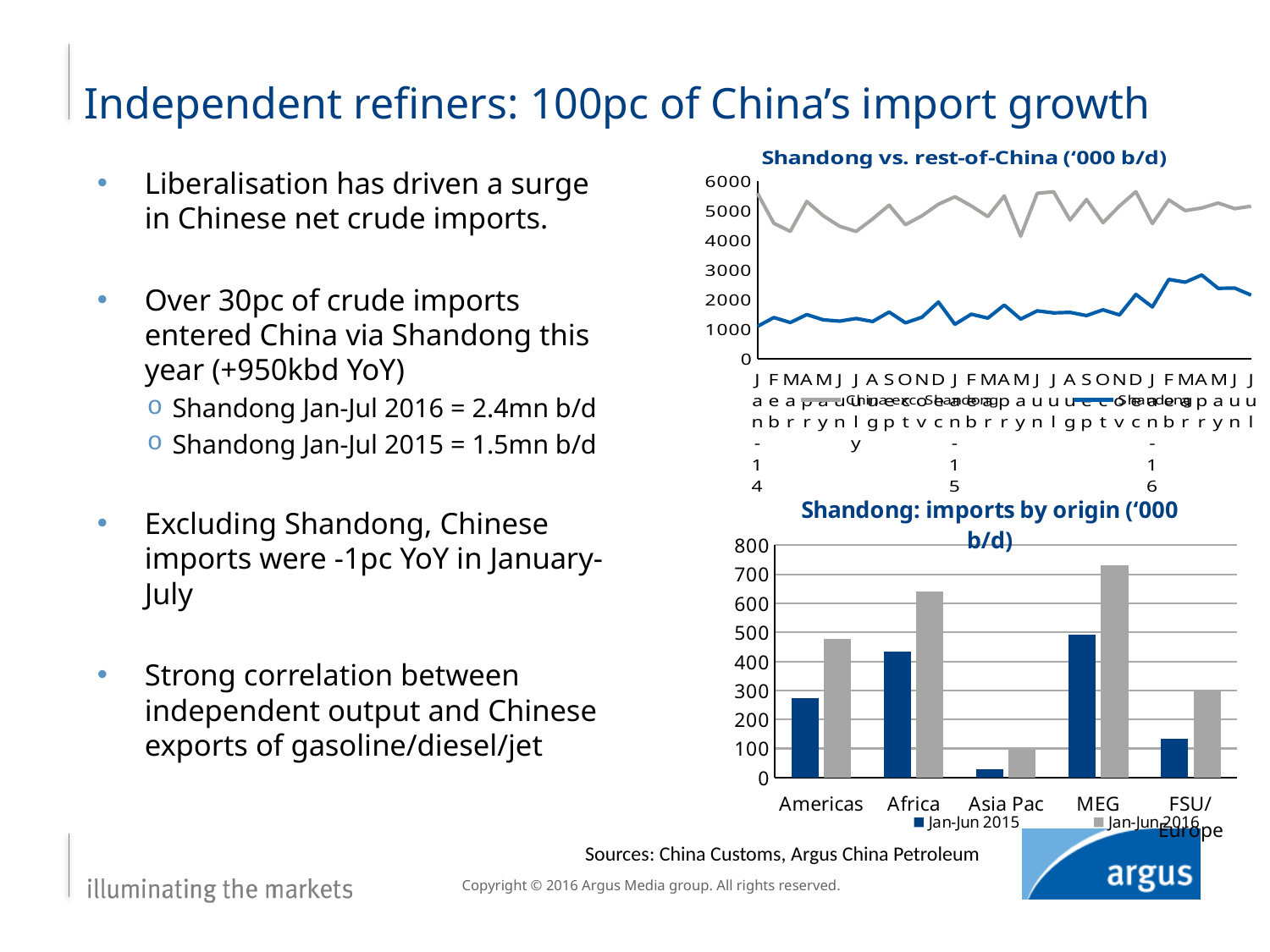
In the 'Shandong: imports by origin' chart, which origin has a larger Jan-Jun 2016 value, Americas or FSU/Europe? Americas In the 'Shandong: imports by origin' chart, what colour are the Jan-Jun 2015 bars? blue In the 'Shandong: imports by origin' chart, is the Jan-Jun 2015 value for Americas greater or less than 300? less In the 'Shandong: imports by origin' chart, what kind of chart is it? bar chart In the 'Shandong vs. rest-of-China' chart, does the Shandong series generally rise or fall from 2014 to 2016? rise In the 'Shandong: imports by origin' chart, is the Jan-Jun 2016 value for MEG greater or less than 700? greater In the 'Shandong: imports by origin' chart, which origin has the lowest Jan-Jun 2015 value? Asia Pac In the 'Shandong: imports by origin' chart, which origin has the highest Jan-Jun 2016 value? MEG In the 'Shandong vs. rest-of-China' chart, what kind of chart is it? line chart In the 'Shandong: imports by origin' chart, which is larger for Africa: Jan-Jun 2015 or Jan-Jun 2016? Jan-Jun 2016 In the 'Shandong: imports by origin' chart, how many origin categories are shown? 5 In the 'Shandong: imports by origin' chart, how many series does the legend list? 2